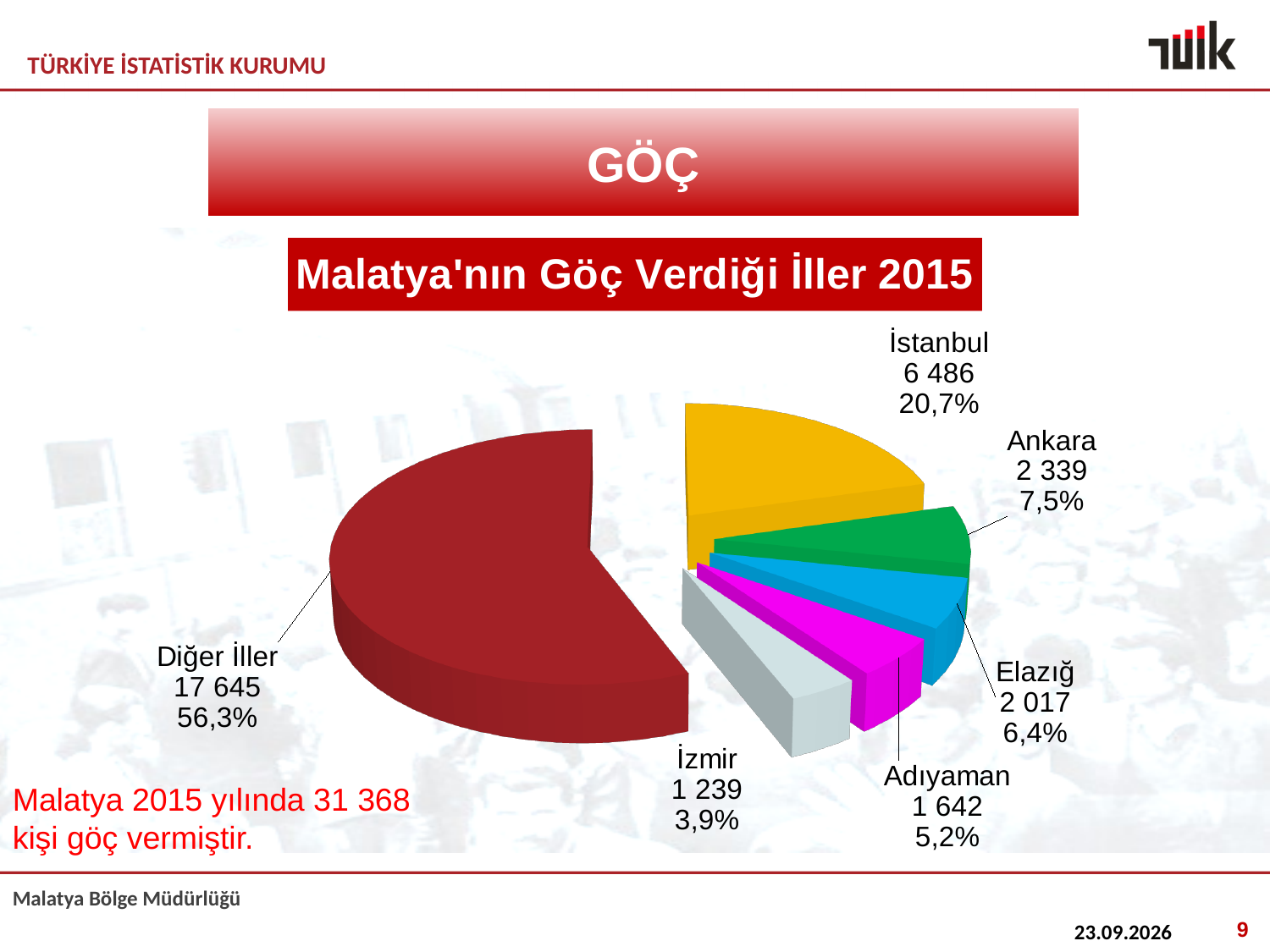
How many slices does the pie chart have? 6 What is the value shown for Elazığ? 2 017 What share of the pie does İstanbul represent? 20,7% What is the value shown for Adıyaman? 1 642 What kind of chart is shown on the slide? pie chart Which slice has the smallest value? İzmir Which slice has the largest value? Diğer İller What is the value shown for İzmir? 1 239 What is the title of the chart? Malatya'nın Göç Verdiği İller 2015 What is the value shown for Ankara? 2 339 What is the difference between the values for Ankara and Elazığ? 322 What is the value shown for İstanbul? 6 486